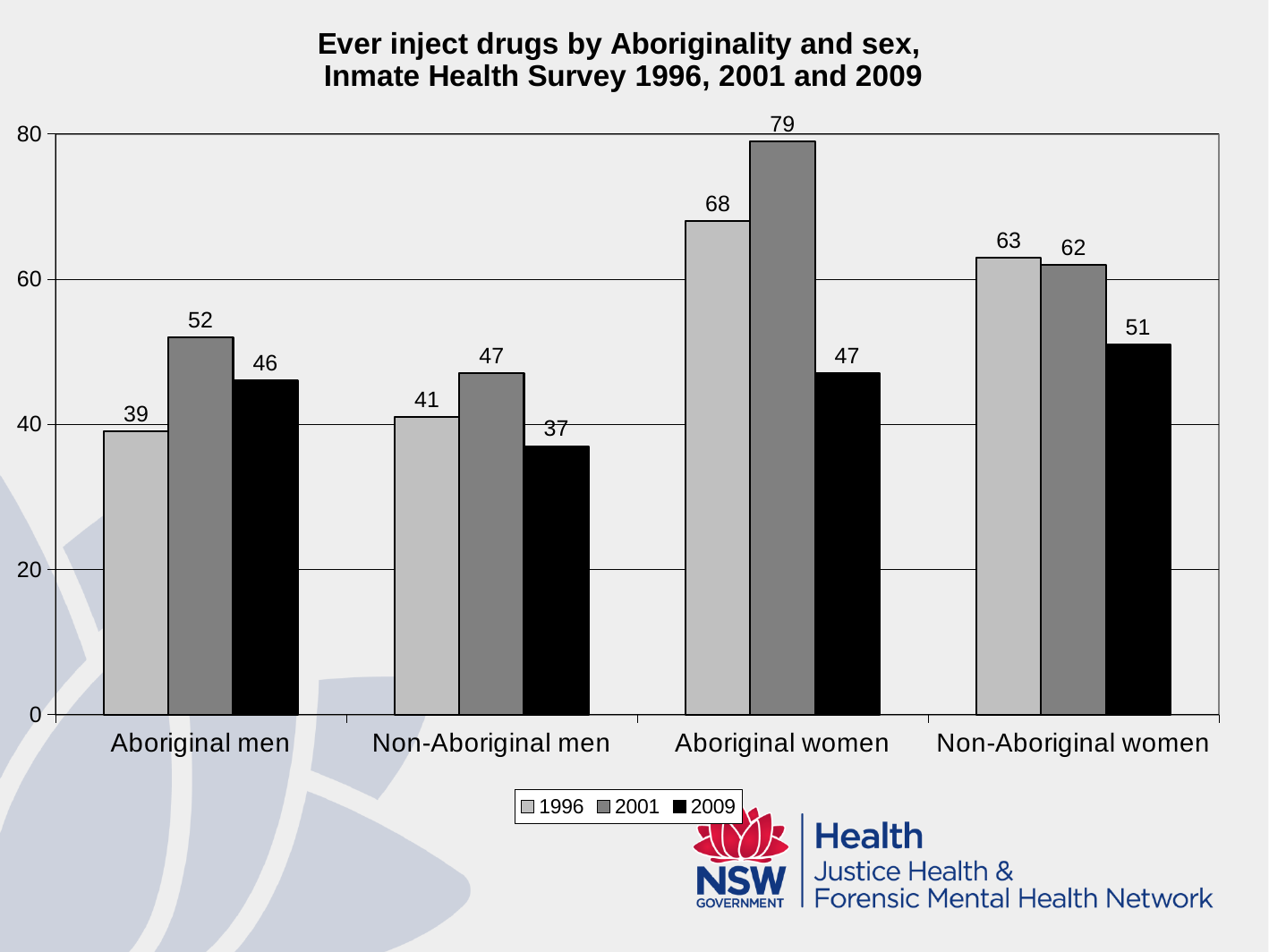
Is the 2009 value for Non-Aboriginal women greater or less than 60? less Which category has the lowest value in the 2009 series? Non-Aboriginal men Which category has the highest value in the 2001 series? Aboriginal women How many categories are shown on the x axis? 4 Which survey year is shown by the black bars? 2009 What is the value for Aboriginal men in 1996? 39 What is the value for Aboriginal women in 2001? 79 What kind of chart is shown on the slide? bar chart Which is larger: the 1996 value for Non-Aboriginal women or the 1996 value for Aboriginal women? Aboriginal women How many series does the legend list? 3 What is the value for Non-Aboriginal men in 2009? 37 What is the difference between the 2001 and 2009 values for Aboriginal women? 32